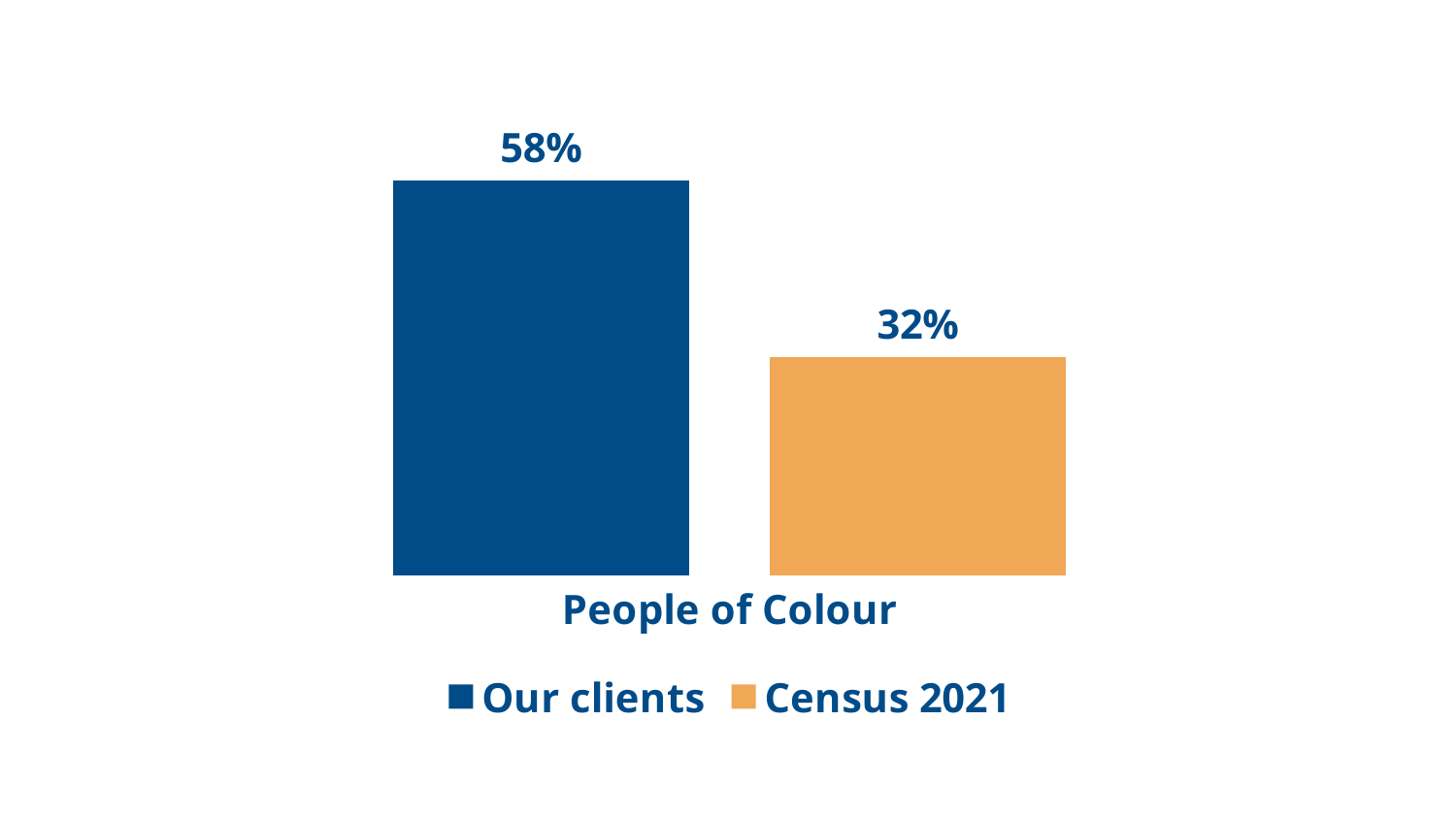
Which series has the higher value for People of Colour? Our clients What is the category label shown below the bars? People of Colour Which series has the lower value for People of Colour? Census 2021 Is the value for Our clients larger or smaller than the value for Census 2021? larger What is the value for Census 2021 in the People of Colour category? 32% Which series is shown in orange? Census 2021 How many series does the legend list? 2 What is the difference between the Our clients value and the Census 2021 value for People of Colour? 26% How many categories are shown on the x axis? 1 What is the value for Our clients in the People of Colour category? 58% What kind of chart is shown on the slide? bar chart